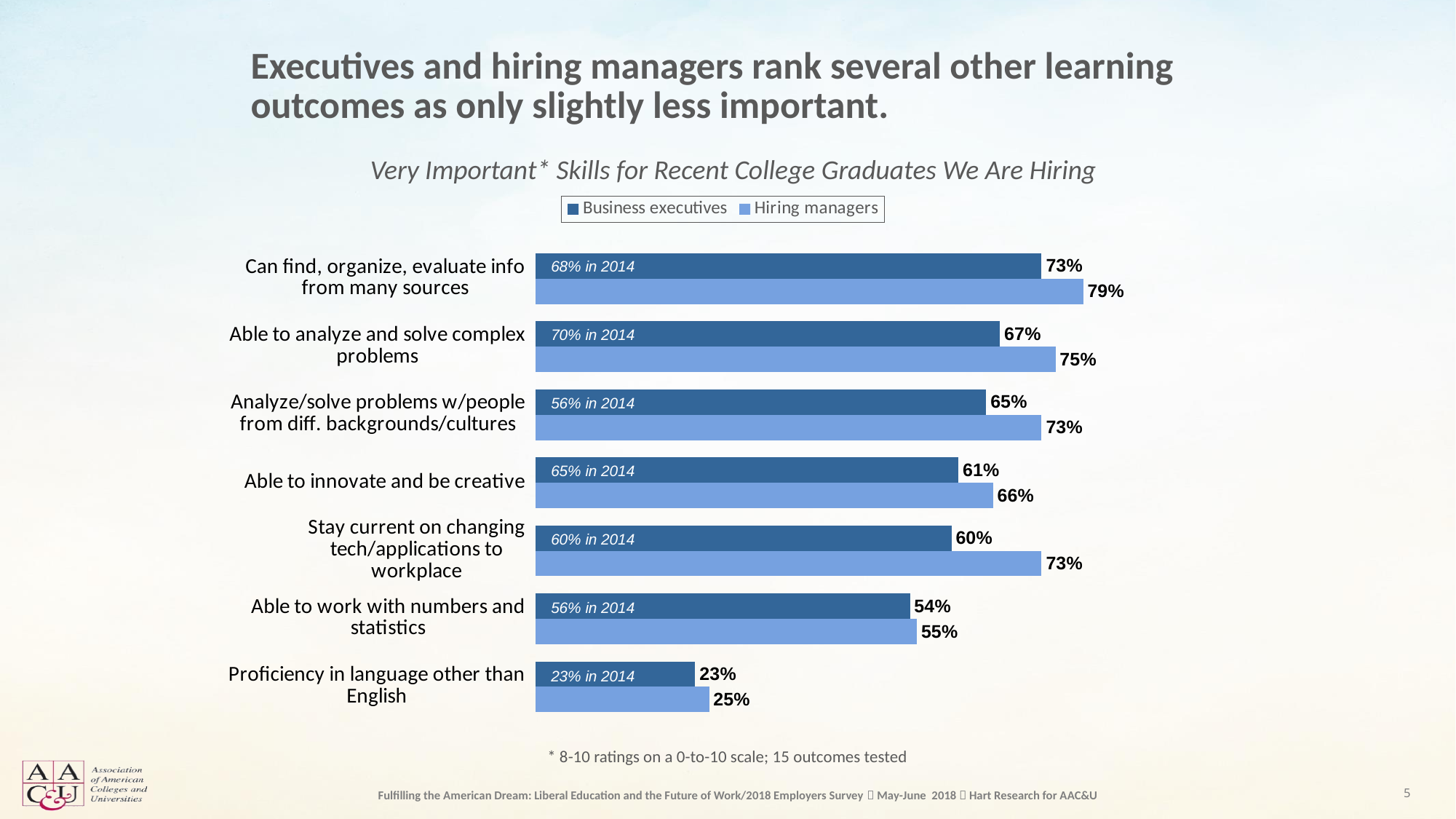
Which skill has the highest percentage among hiring managers? Can find, organize, evaluate info from many sources How many series does the legend list? 2 How many skills are listed in the chart? 7 Which skill has the lowest percentage among business executives? Proficiency in language other than English What percentage of hiring managers rate 'Proficiency in language other than English' as very important? 25% What type of chart is shown on the slide? Bar chart What percentage of hiring managers rate 'Stay current on changing tech/applications to workplace' as very important? 73% What is the difference between hiring managers and business executives for 'Stay current on changing tech/applications to workplace'? 13 percentage points What is the difference between hiring managers and business executives for 'Able to analyze and solve complex problems'? 8 percentage points For 'Able to innovate and be creative', which group has the higher percentage: business executives or hiring managers? Hiring managers What percentage of business executives rate 'Can find, organize, evaluate info from many sources' as very important? 73% What was the 2014 value shown for 'Analyze/solve problems w/people from diff. backgrounds/cultures'? 56%